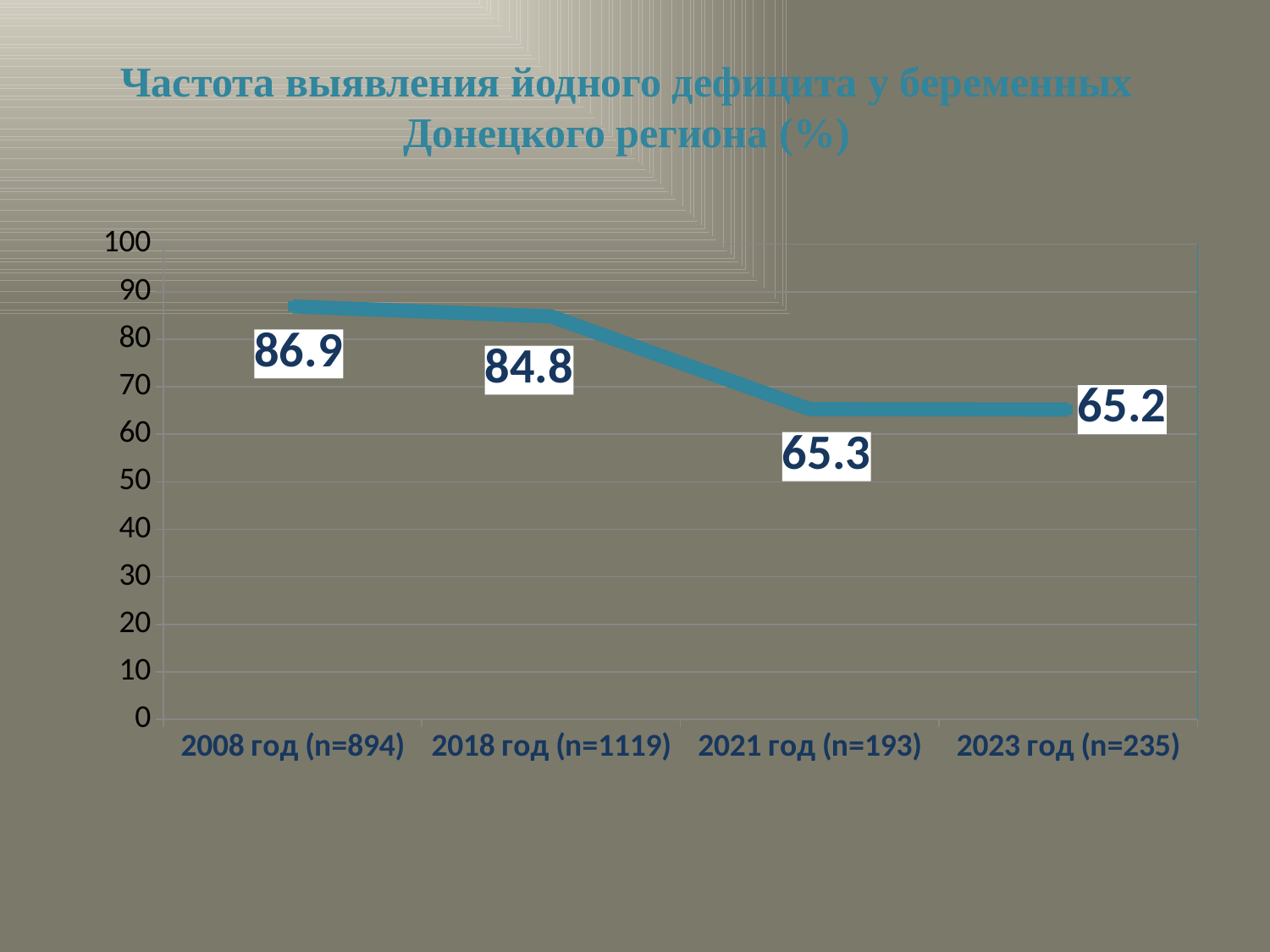
What is the difference between the values for 2008 год (n=894) and 2023 год (n=235)? 21.7 Which category has the highest value? 2008 год (n=894) What is the difference between the values for 2018 год (n=1119) and 2021 год (n=193)? 19.5 What is the value for 2018 год (n=1119)? 84.8 Which is larger, the value for 2018 год (n=1119) or the value for 2021 год (n=193)? 2018 год (n=1119) What is the value for 2021 год (n=193)? 65.3 What is the value for 2023 год (n=235)? 65.2 How many data points are plotted on the chart? 4 What is the value for 2008 год (n=894)? 86.9 Is the value for 2021 год (n=193) greater or less than 70? less What kind of chart is shown on the slide? line chart Do the values rise or fall from 2008 to 2023 along the x axis? fall